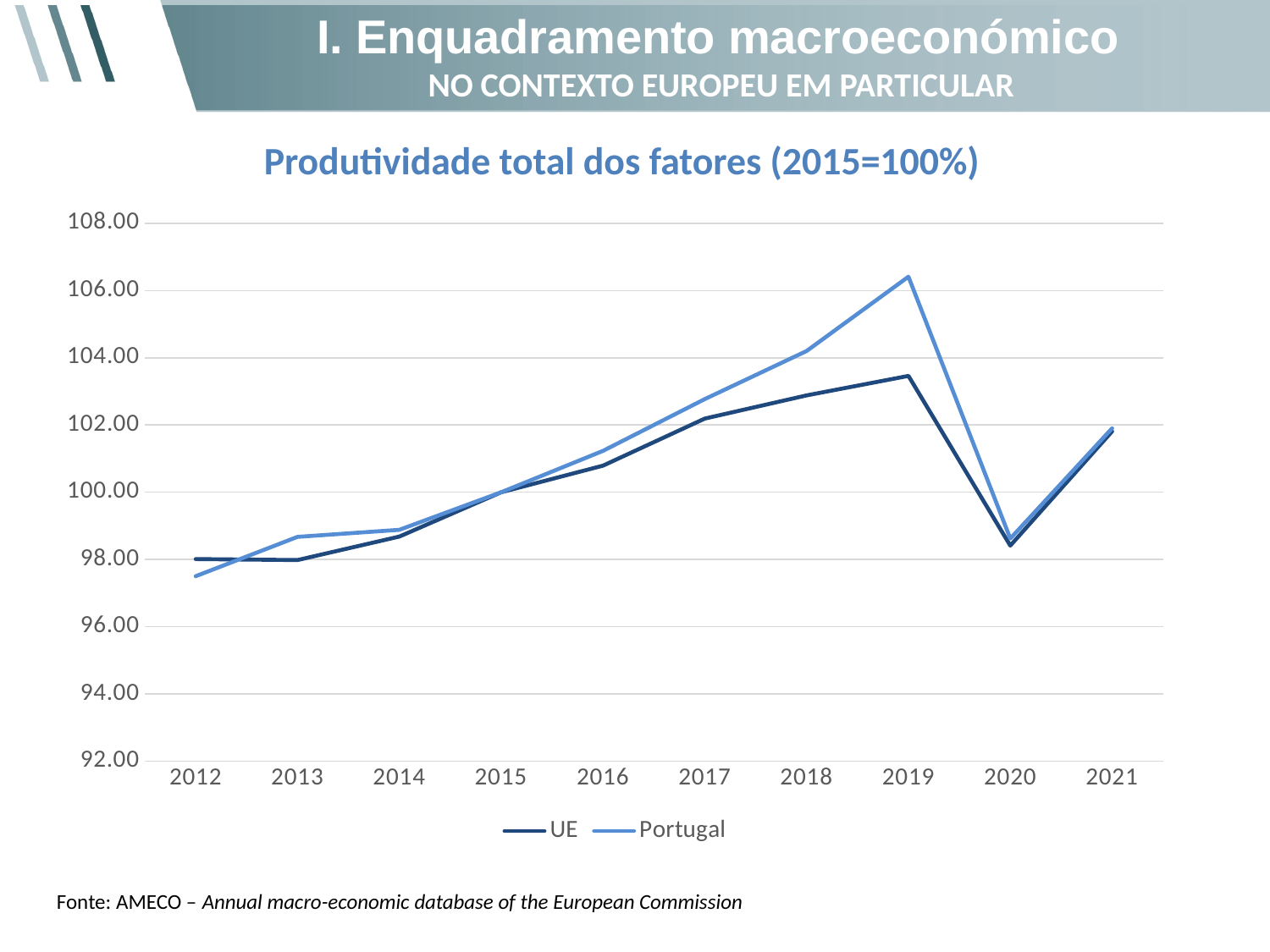
Is the value for Portugal in 2012 greater or less than 98.00? less Is the value for Portugal in 2019 greater or less than 106.00? greater How many series does the legend list? 2 What kind of chart is shown on the slide? line chart In which year does the UE series reach its highest value? 2019 In which year is the Portugal series at its lowest value? 2012 What is the title of the chart? Produtividade total dos fatores (2015=100%) In which year does the Portugal series reach its highest value? 2019 Is the value for UE in 2019 greater or less than 104.00? less Does the Portugal series rise or fall between 2012 and 2019? rise How many years are shown on the x axis? 10 In 2019, which series has the higher value, UE or Portugal? Portugal